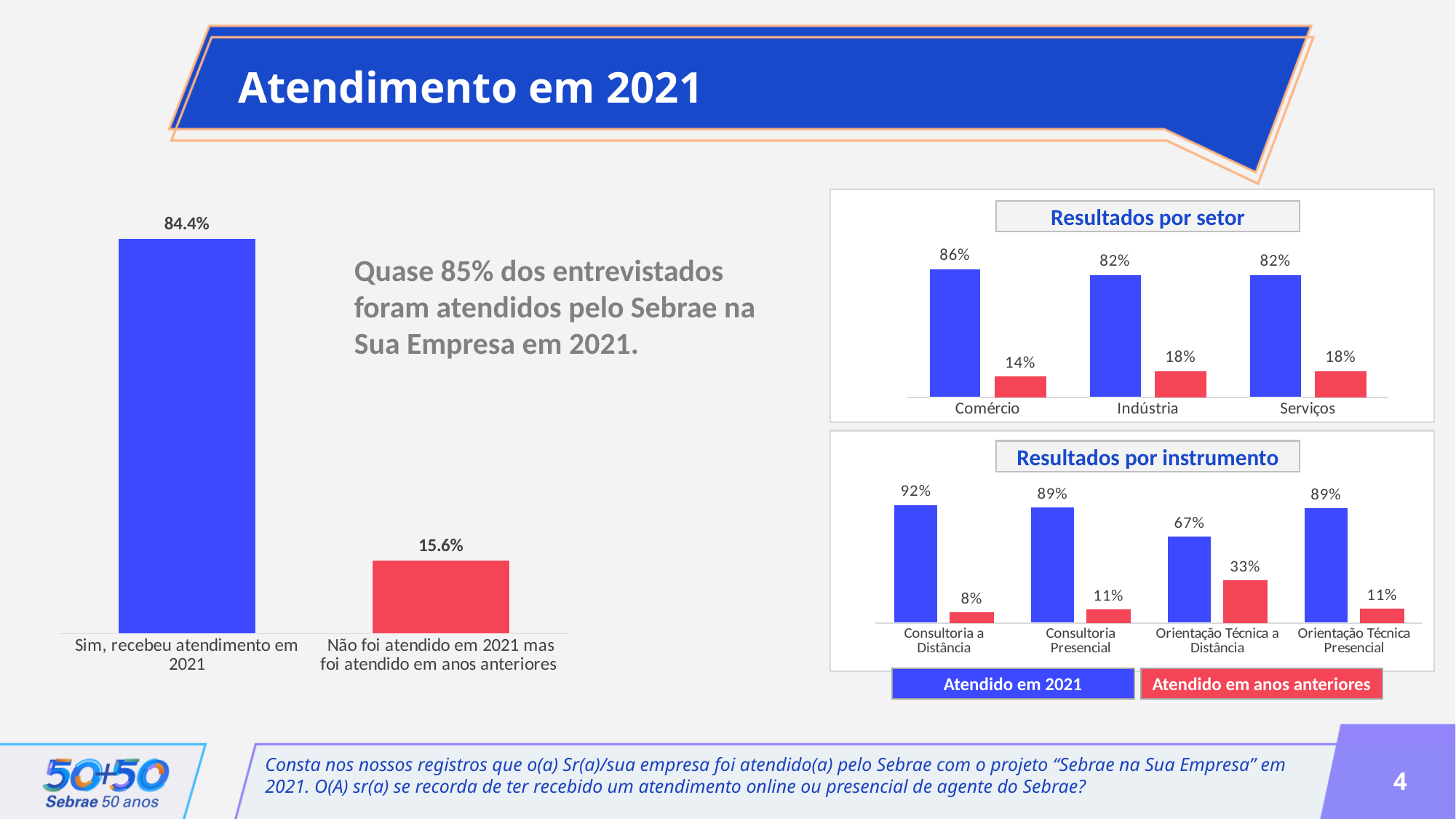
In the "Resultados por instrumento" chart, what is the difference between the "Atendido em 2021" values for Consultoria a Distância and Orientação Técnica a Distância? 25% In the "Resultados por setor" chart, what is the "Atendido em 2021" value for Comércio? 86% In the left-hand chart, what is the difference between the two bars? 68.8% In the "Resultados por instrumento" chart, which instrument has the lowest "Atendido em 2021" value? Orientação Técnica a Distância In the "Resultados por setor" chart, which sector has the highest "Atendido em 2021" value? Comércio In the "Resultados por setor" chart, how many sectors are shown? 3 In the left-hand chart, what is the value for "Sim, recebeu atendimento em 2021"? 84.4% How many series does the legend below the "Resultados por instrumento" chart list? 2 In the left-hand chart, what is the value for "Não foi atendido em 2021 mas foi atendido em anos anteriores"? 15.6% In the "Resultados por instrumento" chart, which is larger: the "Atendido em anos anteriores" value for Orientação Técnica a Distância or for Consultoria a Distância? Orientação Técnica a Distância In the "Resultados por instrumento" chart, what is the "Atendido em 2021" value for Orientação Técnica a Distância? 67% In the "Resultados por setor" chart, what is the "Atendido em anos anteriores" value for Indústria? 18%